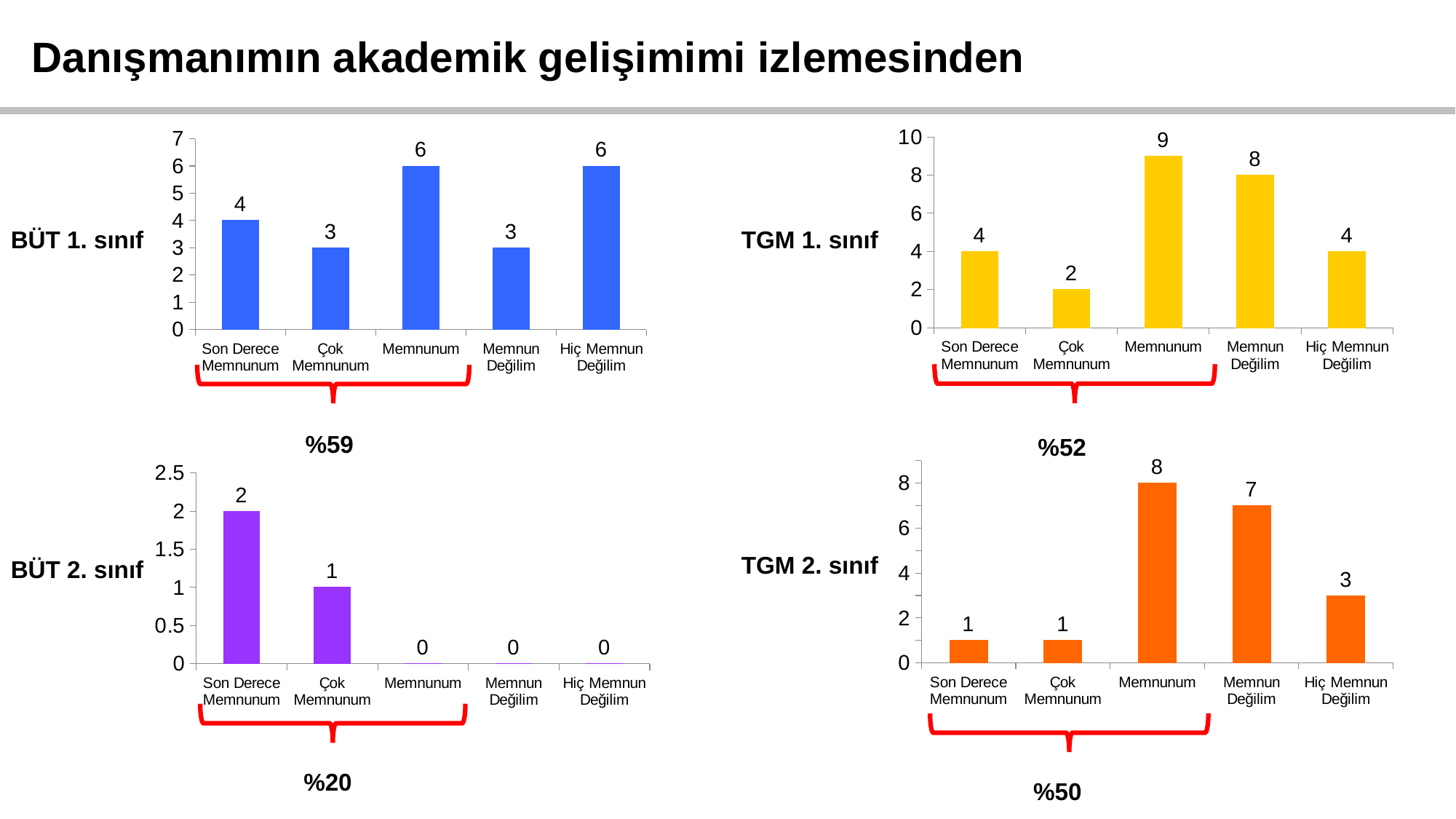
In the BÜT 2. sınıf chart, what is the value for Son Derece Memnunum? 2 In the TGM 1. sınıf chart, what is the value for Memnun Değilim? 8 In the TGM 2. sınıf chart, what is the difference between the values for Memnunum and Hiç Memnun Değilim? 5 In the BÜT 1. sınıf chart, what is the value for Memnunum? 6 In the TGM 1. sınıf chart, which category has the highest value? Memnunum In the TGM 2. sınıf chart, which is larger: the value for Memnun Değilim or the value for Hiç Memnun Değilim? Memnun Değilim How many categories are shown on the x axis of the TGM 1. sınıf chart? 5 In the BÜT 2. sınıf chart, how many categories have a value of 0? 3 In the TGM 1. sınıf chart, which category has the lowest value? Çok Memnunum In the BÜT 1. sınıf chart, what is the difference between the values for Son Derece Memnunum and Çok Memnunum? 1 What percentage is shown under the bracket beneath the TGM 2. sınıf chart? %50 What kind of chart is the BÜT 1. sınıf chart? Bar chart